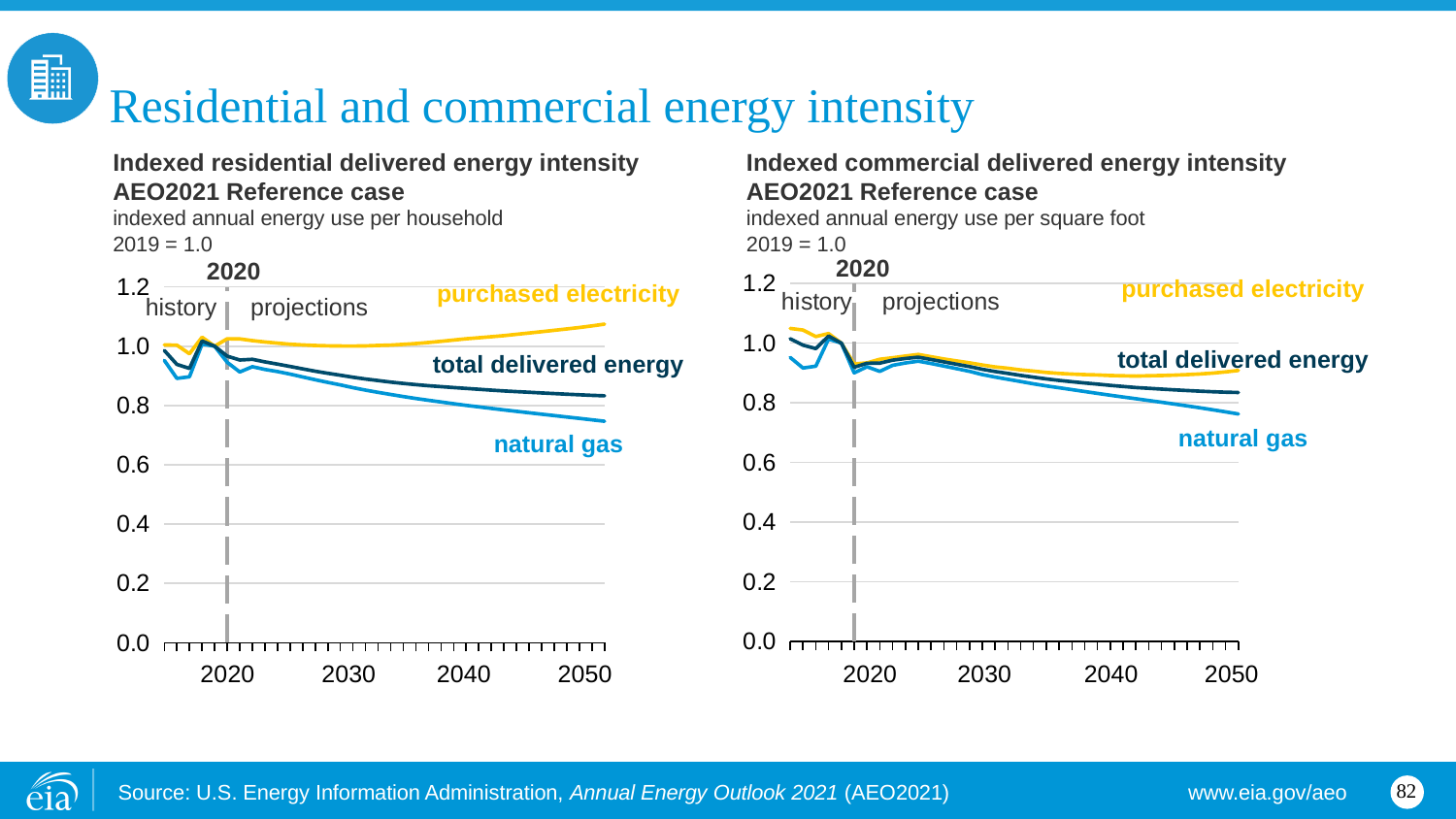
According to the subtitle of the left chart, what is the index value for 2019? 1.0 In the left chart (residential), is the value for natural gas in 2050 greater or less than 0.8? less In the left chart (residential), does the natural gas series rise or fall over the projection period from 2020 to 2050? fall In the right chart (commercial), is the value for purchased electricity in 2050 greater or less than 1.0? less In the left chart (residential), is the value for purchased electricity in 2050 greater or less than 1.0? greater In the right chart (commercial), which series has the lowest value in 2050? natural gas What type of chart is the 'Indexed residential delivered energy intensity' chart on the left? line chart What year does the dashed vertical line separating history from projections mark on both charts? 2020 In the left chart (residential), which series has the highest value in 2050? purchased electricity In the right chart (commercial), which is larger in 2050: total delivered energy or natural gas? total delivered energy How many series are labeled on the 'Indexed commercial delivered energy intensity' chart on the right? 3